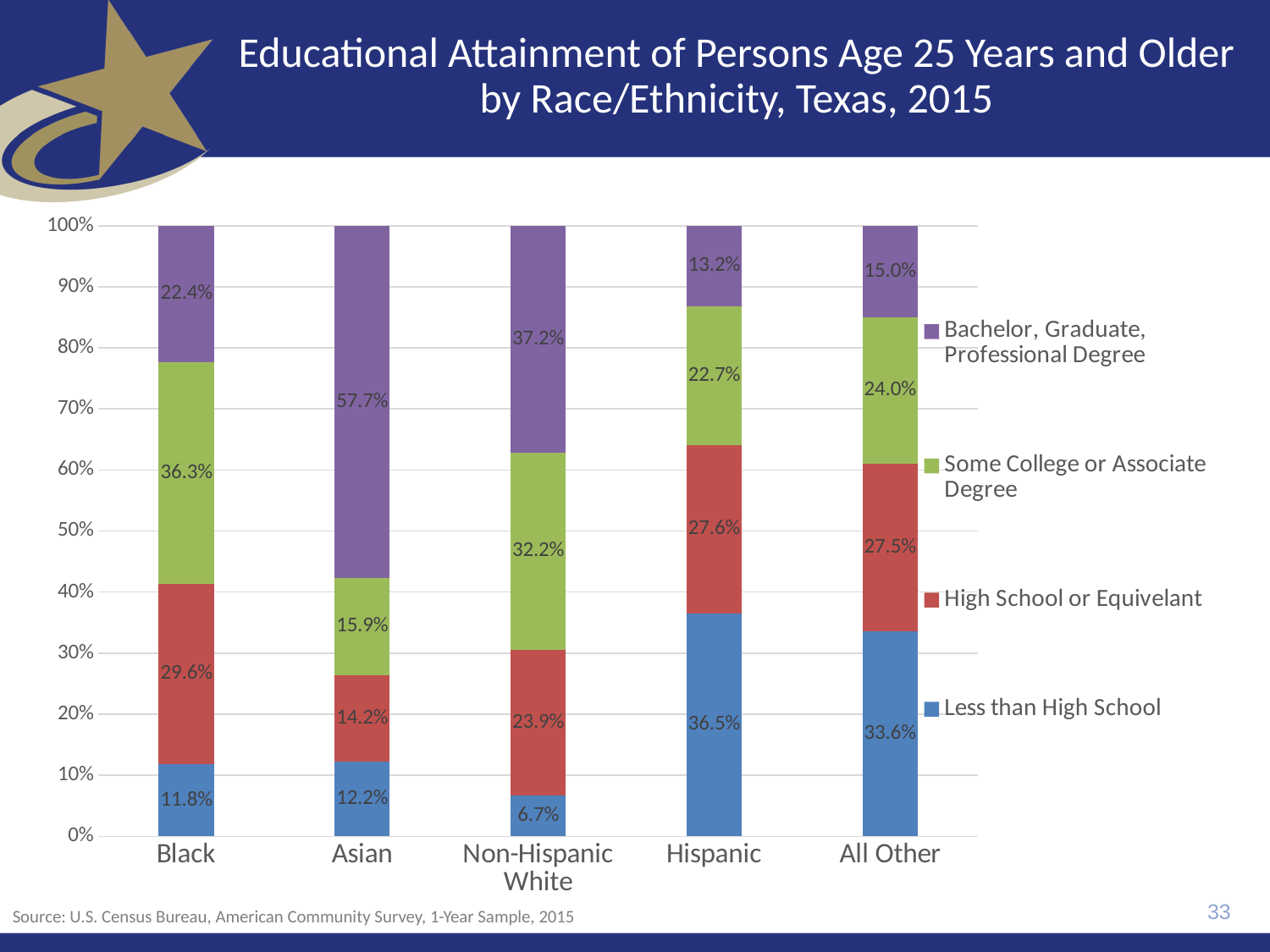
What is the difference between the Less than High School values for Hispanic and Black? 24.7% Which race/ethnicity group has the lowest Less than High School share? Non-Hispanic White Which colour represents Less than High School in the chart? Blue Which is larger, the High School or Equivelant value for Black or for Asian? Black What is the Less than High School value for Hispanic? 36.5% What is the High School or Equivelant value for All Other? 27.5% How many race/ethnicity categories are shown on the x axis? 5 How many series does the legend list? 4 What kind of chart is shown on the slide? Stacked bar chart Which race/ethnicity group has the highest Bachelor, Graduate, Professional Degree share? Asian What percentage of Asians have a Bachelor, Graduate, or Professional Degree? 57.7% What is the Some College or Associate Degree value for Non-Hispanic White? 32.2%